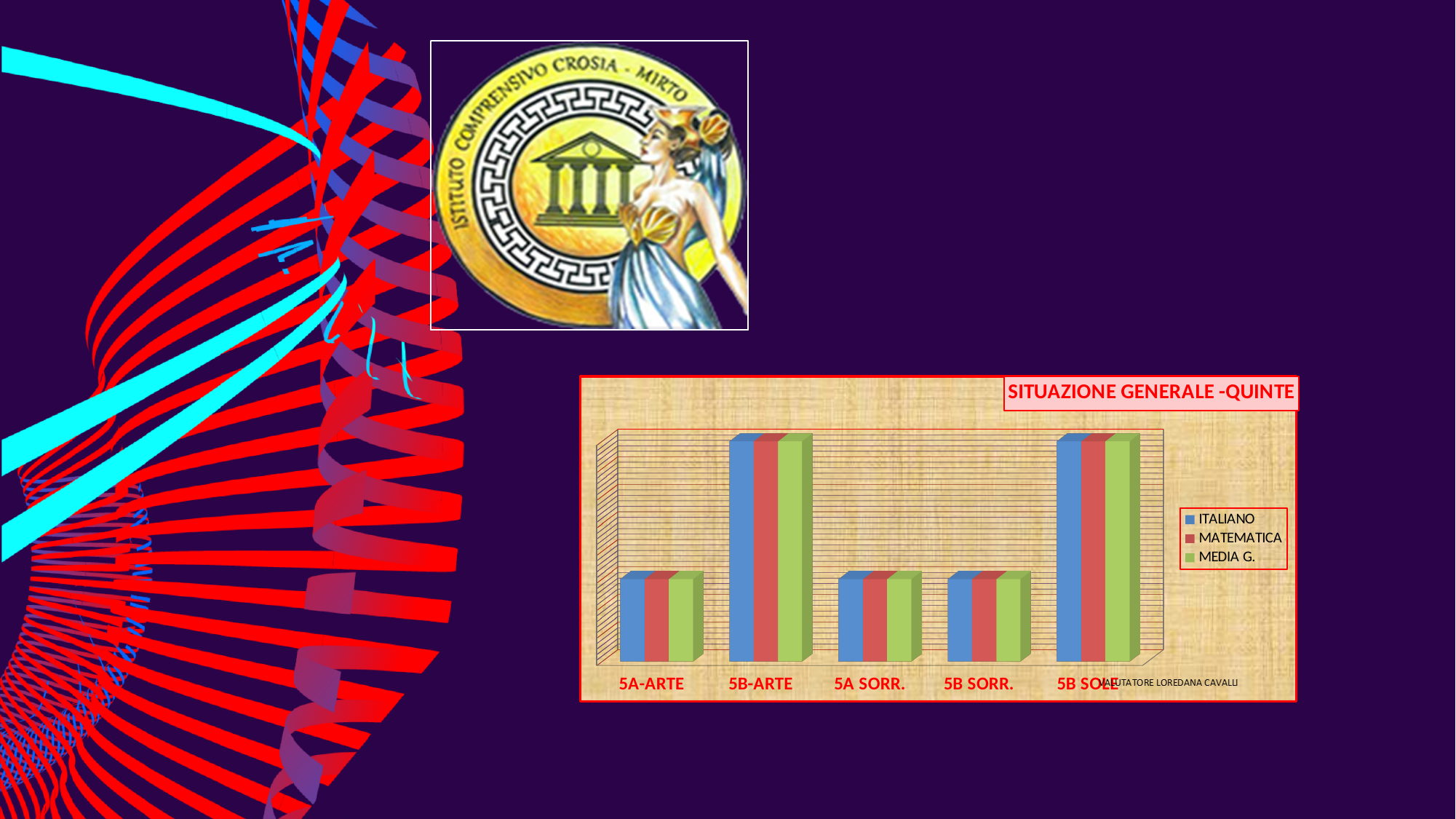
What kind of chart is shown on the slide? bar chart Is the MATEMATICA value for 5A SORR. larger or smaller than the MATEMATICA value for 5B-ARTE? smaller Is the MEDIA G. value for 5B SOLE larger or smaller than the MEDIA G. value for 5B SORR.? larger How many categories are shown along the x axis of the chart? 5 Do the ITALIANO values rise steadily, fall steadily, or go up and down across the categories from left to right? go up and down What is the title of the chart? SITUAZIONE GENERALE -QUINTE Is the ITALIANO value for 5B-ARTE larger or smaller than the ITALIANO value for 5A-ARTE? larger How many series does the chart's legend list? 3 Which series is shown in blue in the chart's legend? ITALIANO